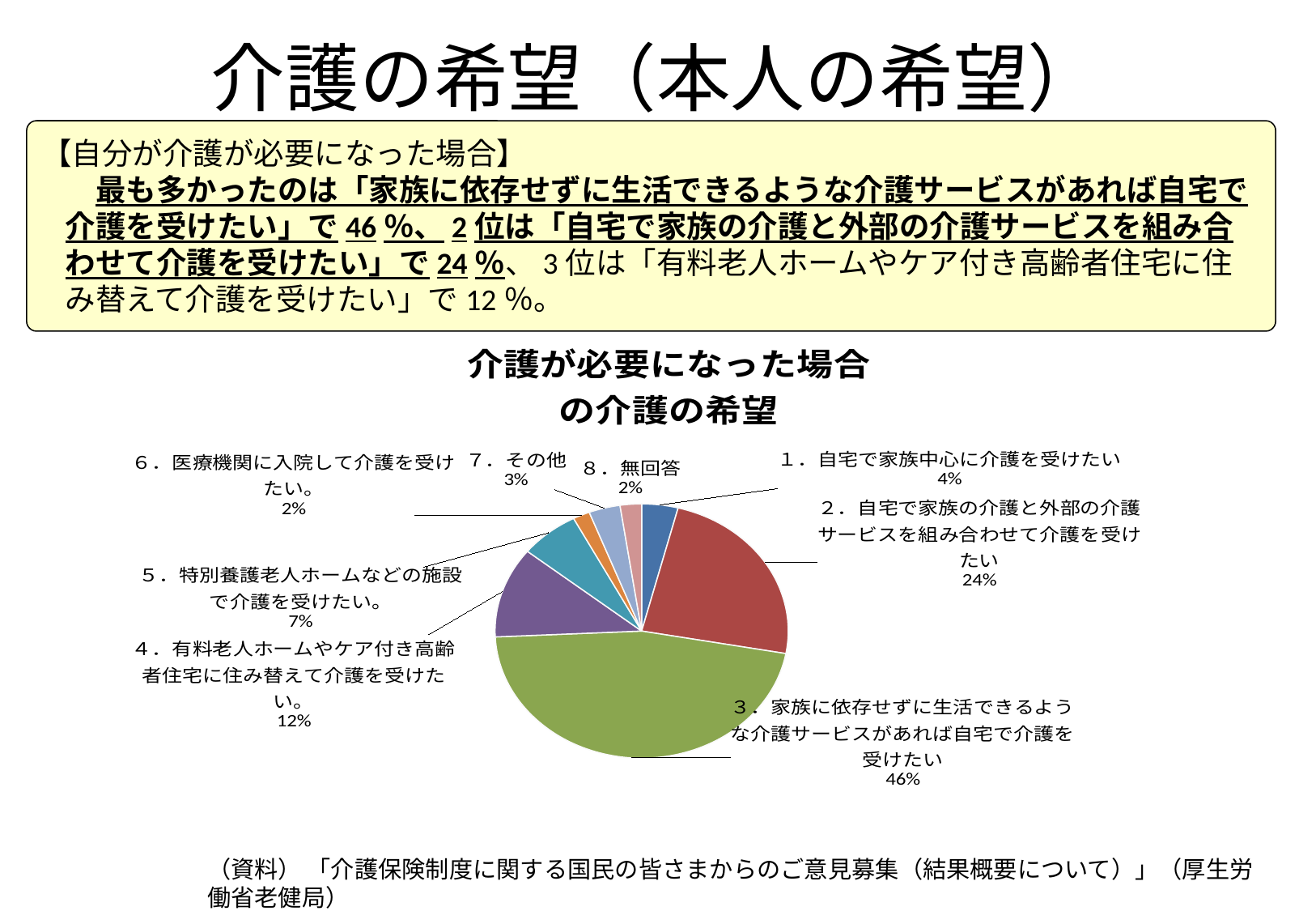
What type of chart is shown on the slide? Pie chart What percentage is shown for "２．自宅で家族の介護と外部の介護サービスを組み合わせて介護を受けたい"? 24% Which is larger: the share for "５．特別養護老人ホームなどの施設で介護を受けたい" or for "１．自宅で家族中心に介護を受けたい"? ５．特別養護老人ホームなどの施設で介護を受けたい What percentage is shown for "５．特別養護老人ホームなどの施設で介護を受けたい"? 7% What percentage is shown for "４．有料老人ホームやケア付き高齢者住宅に住み替えて介護を受けたい"? 12% What percentage is shown for "１．自宅で家族中心に介護を受けたい"? 4% How many categories (slices) does the pie chart have? 8 What is the title of the pie chart? 介護が必要になった場合の介護の希望 What percentage is shown for "７．その他"? 3% What percentage is shown for "３．家族に依存せずに生活できるような介護サービスがあれば自宅で介護を受けたい"? 46% Which category has the largest share of the pie chart? ３．家族に依存せずに生活できるような介護サービスがあれば自宅で介護を受けたい What is the difference in percentage points between category 3 (46%) and category 2 (24%)? 22